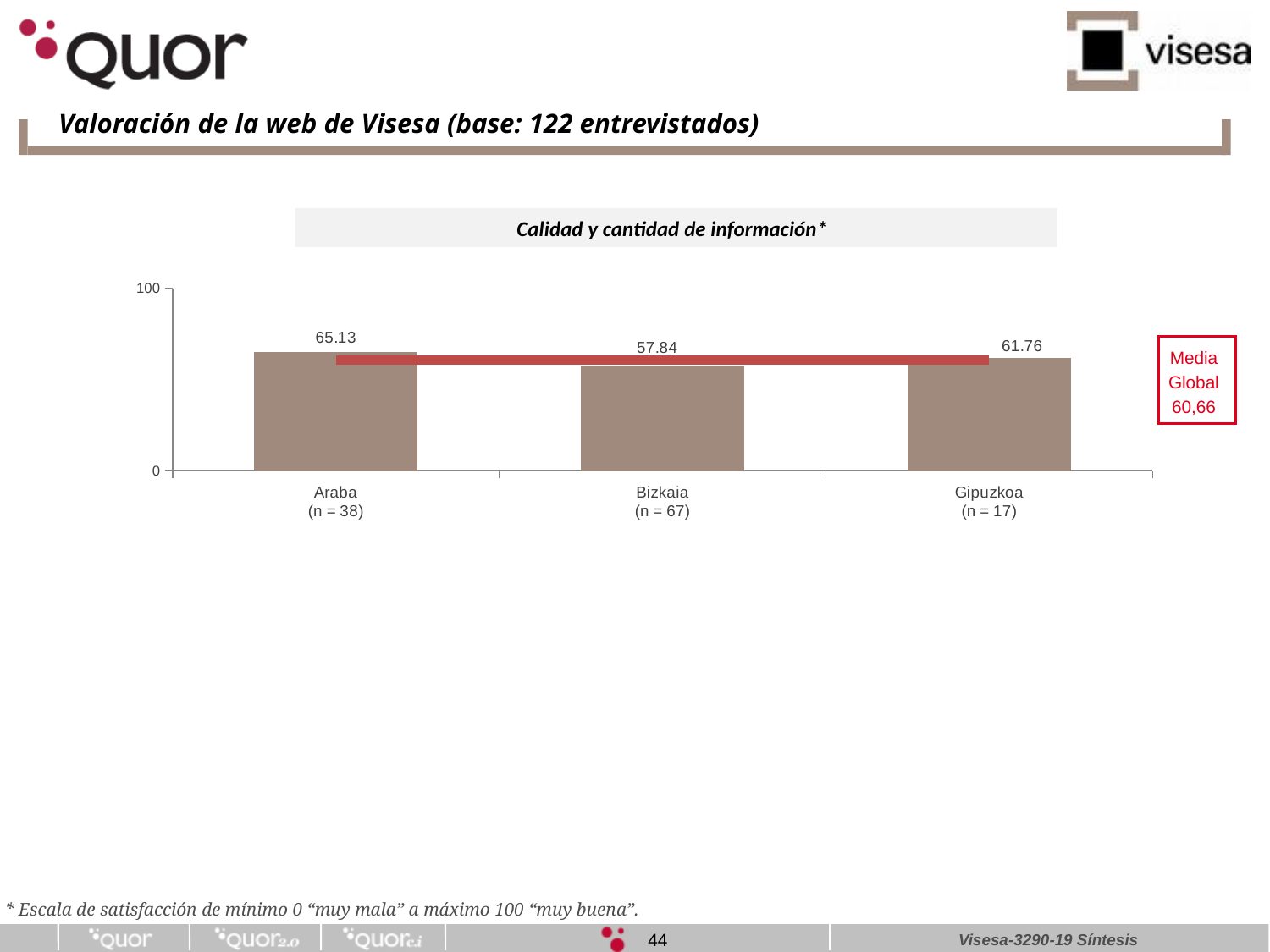
What kind of chart is this? bar chart What is the value for Bizkaia? 57.84 What is the difference between the values for Araba and Bizkaia? 7.29 What is the title of the chart? Calidad y cantidad de información* How many categories are shown on the x axis? 3 Which category has the lowest value? Bizkaia Which is larger, the value for Araba or the value for Gipuzkoa? Araba What is the value for Araba? 65.13 Which category has the highest value? Araba What is the Media Global value shown next to the chart? 60,66 What is the difference between the values for Gipuzkoa and Bizkaia? 3.92 What is the value for Gipuzkoa? 61.76